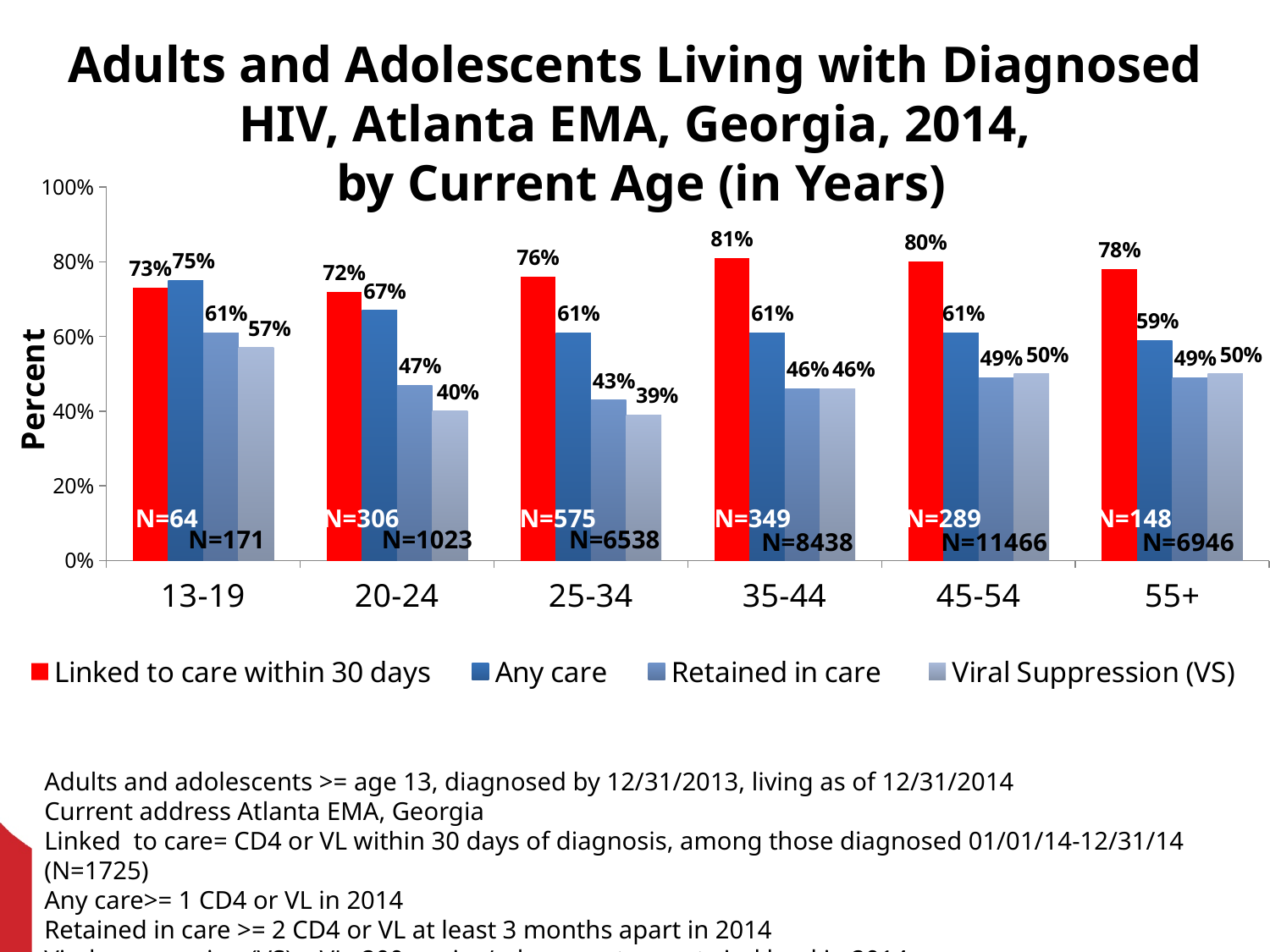
What kind of chart is shown on the slide? Bar chart What is the value for Linked to care within 30 days in the 35-44 age group? 81% How many series does the legend list? 4 Which age group has the highest value for Linked to care within 30 days? 35-44 Does the Viral Suppression (VS) value rise or fall from the 13-19 group to the 25-34 group? Fall What is the Any care value for the 55+ age group? 59% In the 20-24 age group, what is the difference between the Any care value and the Retained in care value? 20 percentage points Which age group has the lowest Viral Suppression (VS) value? 25-34 What colour are the bars for Linked to care within 30 days? Red Which age group has a higher Retained in care value, 13-19 or 20-24? 13-19 What is the Viral Suppression (VS) value for the 13-19 age group? 57% How many age groups are shown on the x axis? 6